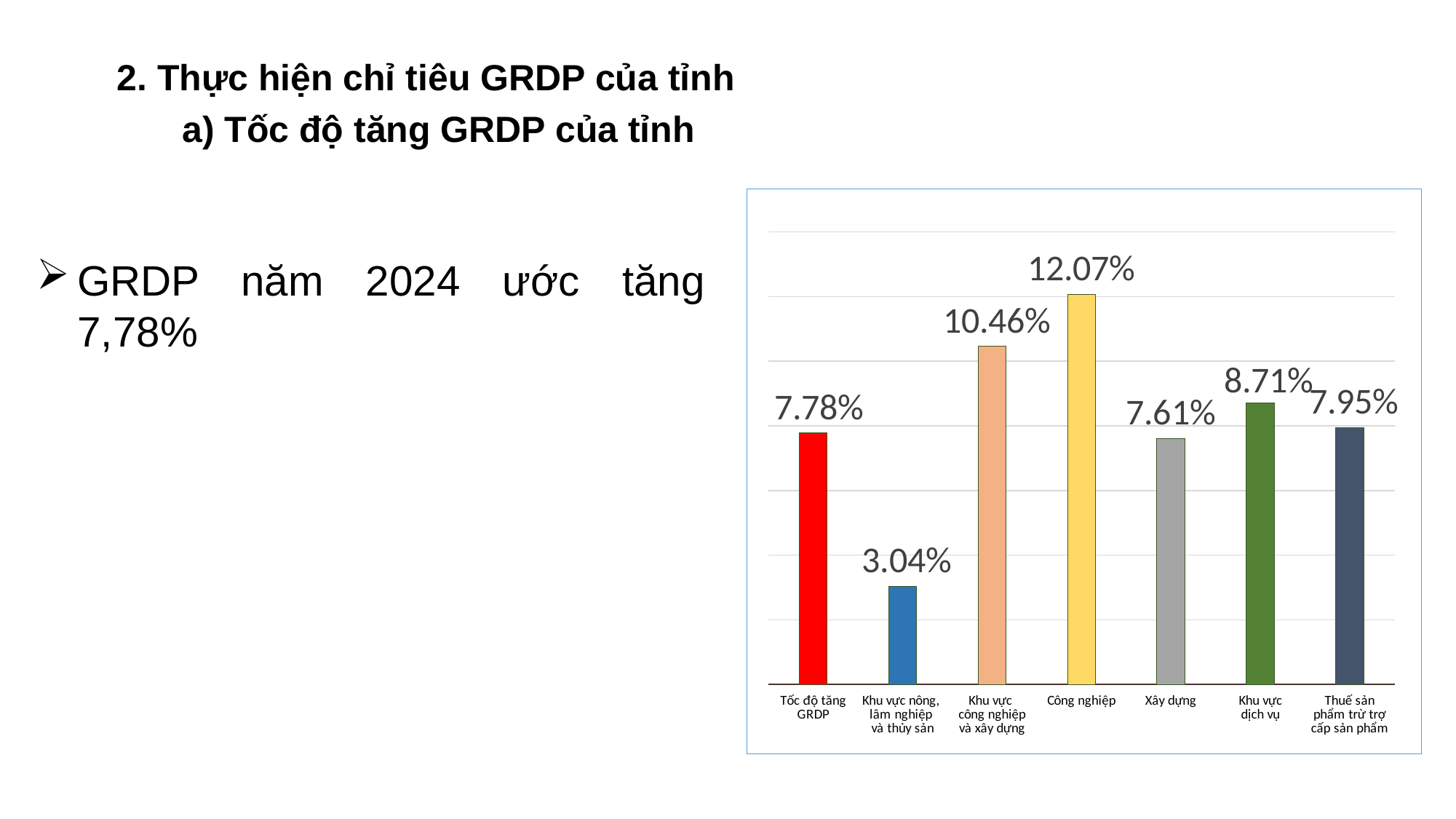
What kind of chart is shown on the slide? Bar chart What is the value for Khu vực nông, lâm nghiệp và thủy sản? 3.04% What is the difference between the values for Khu vực công nghiệp và xây dựng and Tốc độ tăng GRDP? 2.68% How many categories are shown in the chart? 7 What is the difference between the values for Công nghiệp and Xây dựng? 4.46% Which category has the lowest value? Khu vực nông, lâm nghiệp và thủy sản Which is larger, the value for Khu vực dịch vụ or the value for Thuế sản phẩm trừ trợ cấp sản phẩm? Khu vực dịch vụ What is the value for Công nghiệp? 12.07% Which category has the highest value? Công nghiệp What is the value for Thuế sản phẩm trừ trợ cấp sản phẩm? 7.95% What colour is the bar for Tốc độ tăng GRDP? Red What is the value for Khu vực dịch vụ? 8.71%